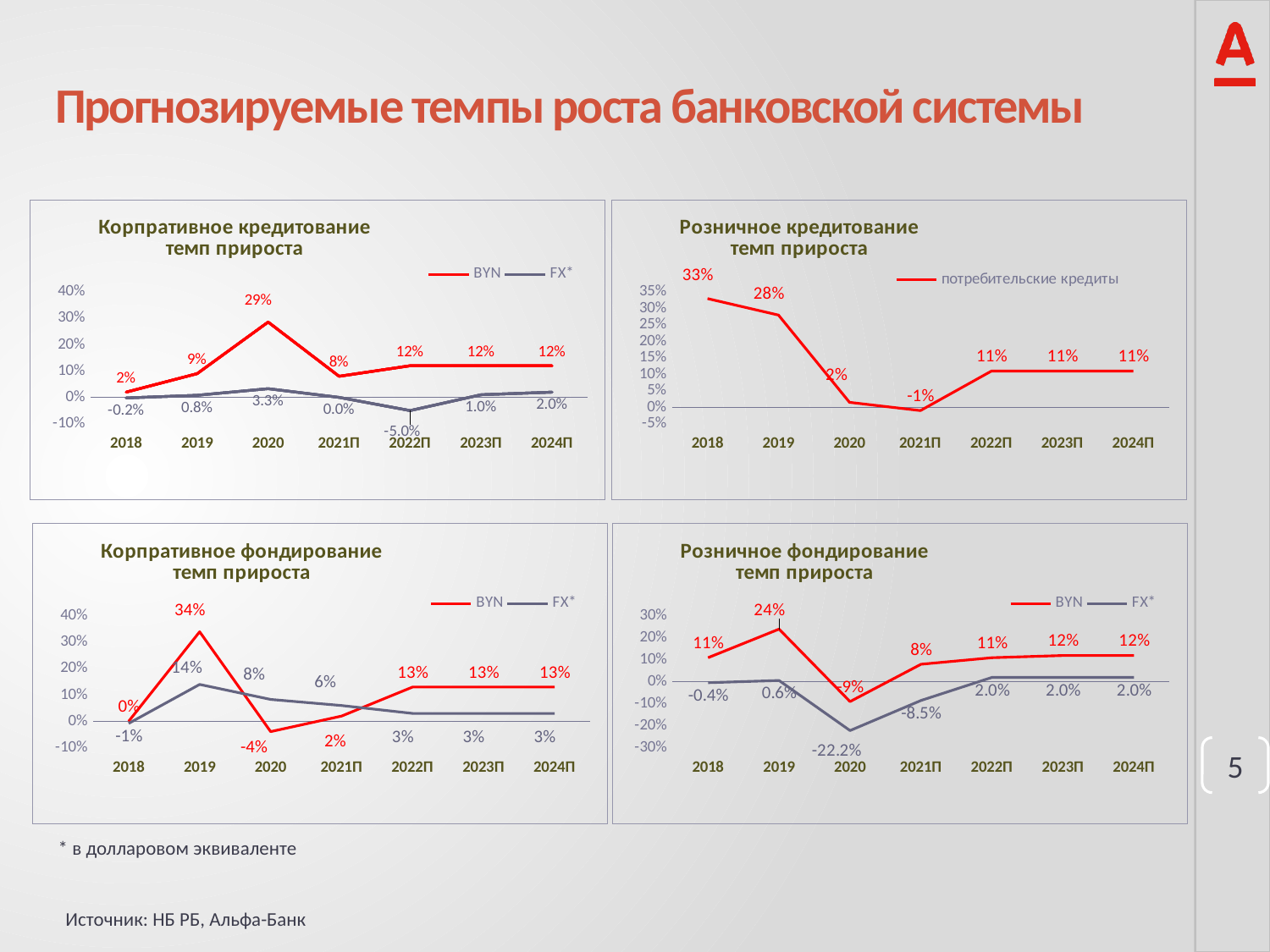
In the bottom-left chart (Корпративное фондирование темп прироста), what is the BYN value for 2019? 34% In the top-right chart (Розничное кредитование темп прироста), which year has the lowest value? 2021П In the top-right chart (Розничное кредитование темп прироста), what is the value for 2019? 28% In the bottom-right chart (Розничное фондирование темп прироста), what is the difference between the BYN value for 2019 and the BYN value for 2018? 13% In the top-left chart (Корпративное кредитование темп прироста), what is the BYN value for 2020? 29% In the bottom-right chart (Розничное фондирование темп прироста), what is the FX* value for 2020? -22.2% In the top-left chart (Корпративное кредитование темп прироста), what is the FX* value for 2022П? -5.0% In the bottom-left chart (Корпративное фондирование темп прироста), which is larger in 2020: BYN or FX*? FX* In the top-left chart (Корпративное кредитование темп прироста), which year has the highest BYN value? 2020 What type of chart is the top-right chart (Розничное кредитование темп прироста)? Line chart In the top-right chart (Розничное кредитование темп прироста), what is the difference between the 2018 value and the 2019 value? 5% How many series does the legend of the bottom-right chart (Розничное фондирование темп прироста) list? 2